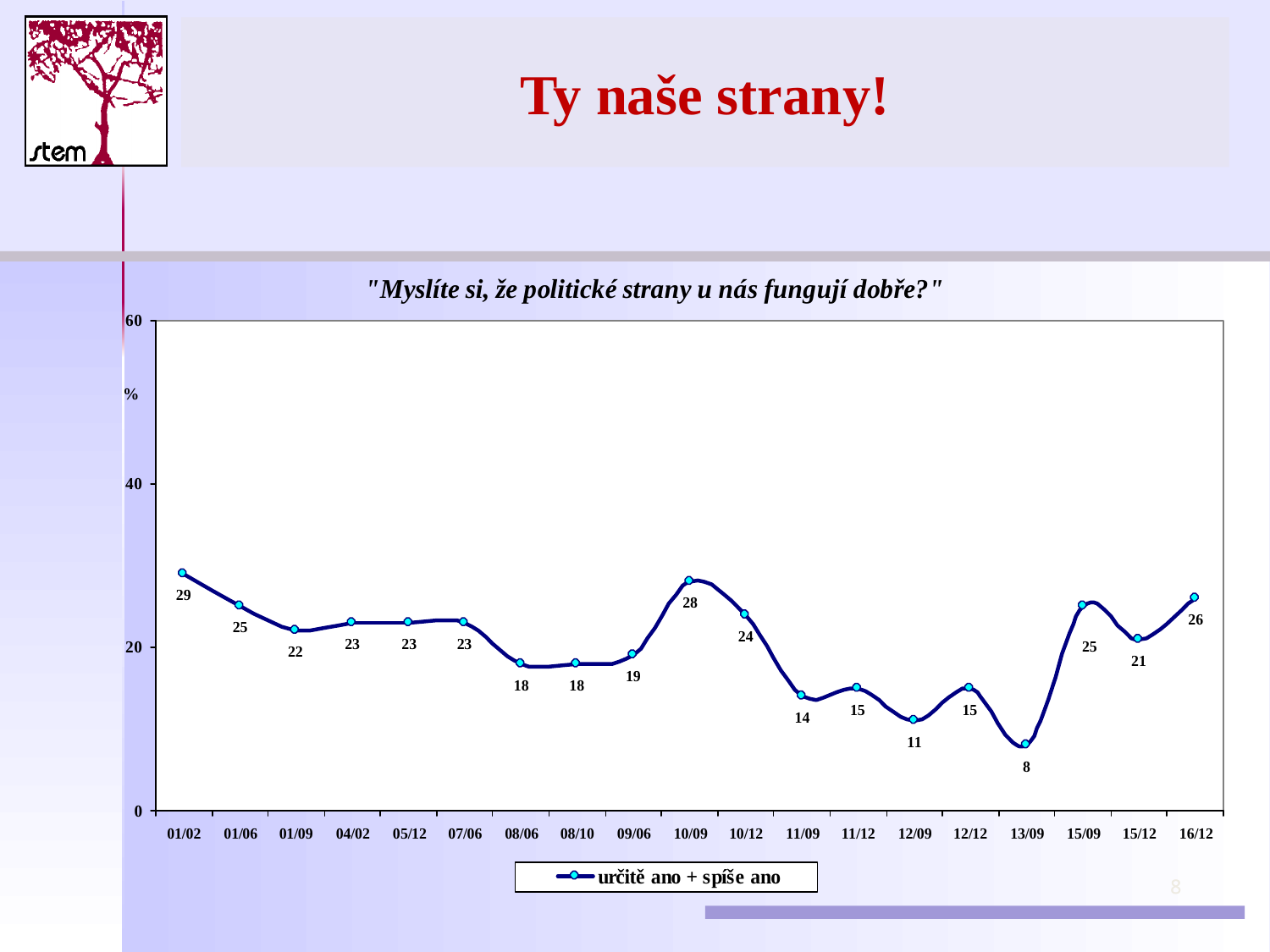
Which time point has the highest value? 01/02 What is the value for 01/02? 29 Which time point has the lowest value? 13/09 Is the value for 12/09 greater or less than 20? less What is the legend entry for the plotted series? určitě ano + spíše ano Which is larger, the value for 10/09 or the value for 11/09? 10/09 What is the difference between the values for 01/02 and 13/09? 21 What is the value for 16/12? 26 How many time points are plotted on the chart? 19 What is the value for 13/09? 8 What kind of chart is shown on the slide? line chart What is the value for 10/09? 28